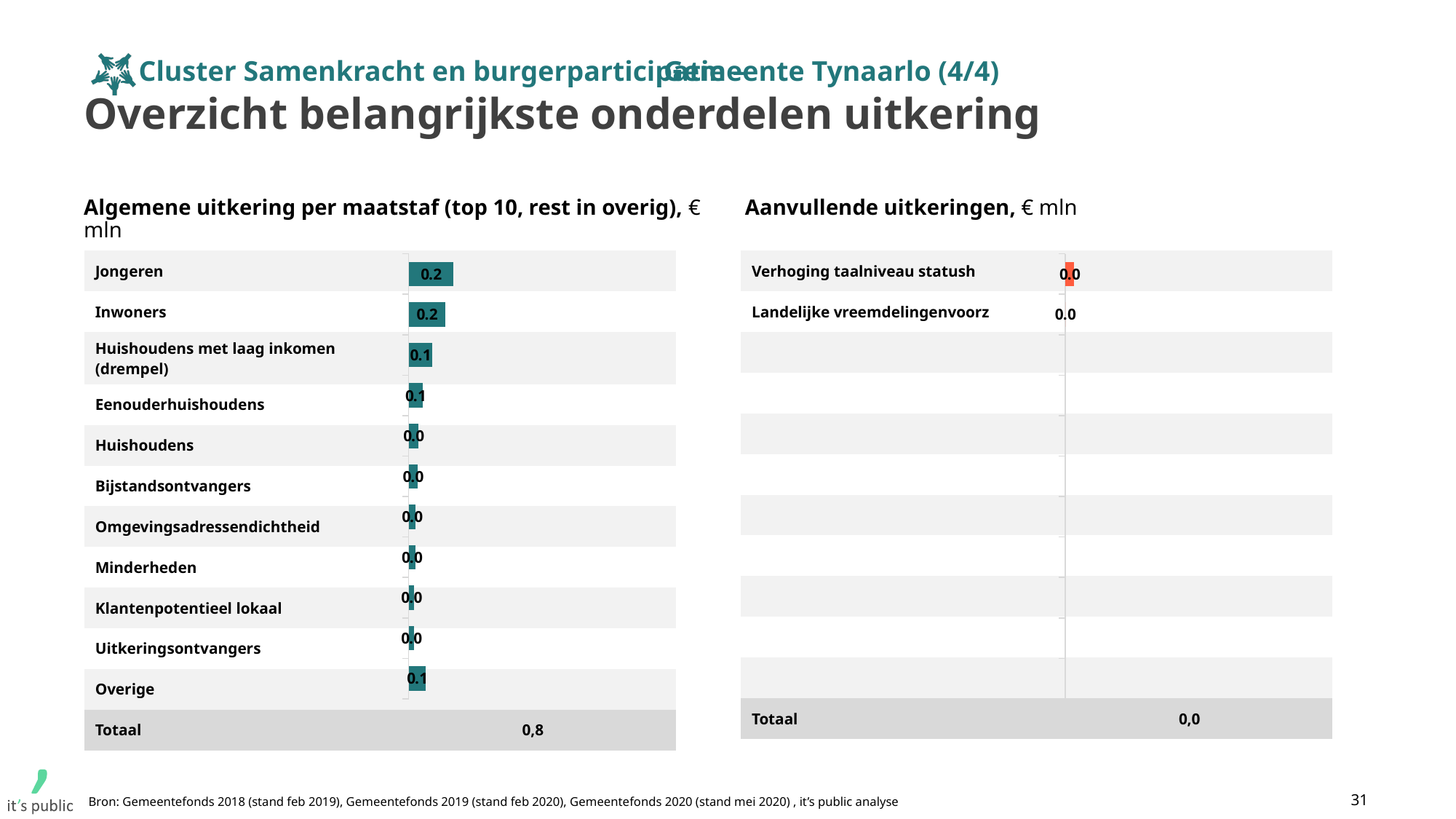
In the chart 'Algemene uitkering per maatstaf', what is the value for Overige? 0.1 What kind of chart is 'Algemene uitkering per maatstaf'? Bar chart In the chart 'Algemene uitkering per maatstaf', what is the difference between the value for Inwoners and the value for Eenouderhuishoudens? 0.1 In the chart 'Algemene uitkering per maatstaf', what is the value for Bijstandsontvangers? 0.0 How many categories (excluding Totaal) are shown in the chart 'Algemene uitkering per maatstaf'? 11 In the chart 'Algemene uitkering per maatstaf', what is the value for Huishoudens met laag inkomen (drempel)? 0.1 In the chart 'Aanvullende uitkeringen', what is the Totaal shown? 0,0 In the chart 'Algemene uitkering per maatstaf', which is larger, the value for Jongeren or the value for Huishoudens? Jongeren How many categories (excluding Totaal) are labelled in the chart 'Aanvullende uitkeringen'? 2 In the chart 'Algemene uitkering per maatstaf', what is the value for Jongeren? 0.2 In the chart 'Algemene uitkering per maatstaf', what is the Totaal shown? 0,8 In the chart 'Aanvullende uitkeringen', what is the value for Verhoging taalniveau statush? 0.0